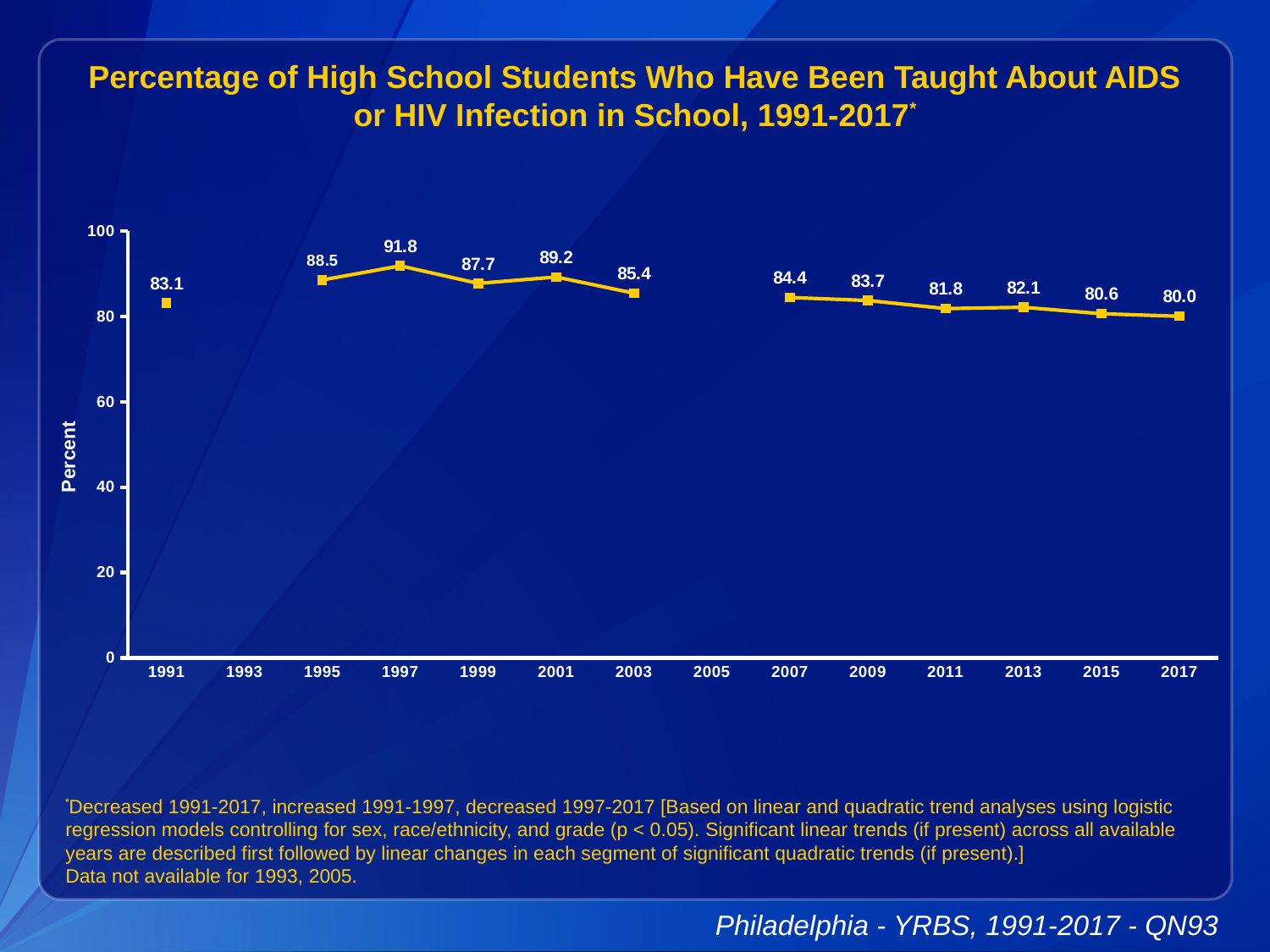
How many data points are plotted on the chart? 12 What value is shown for 2007? 84.4 What value is shown for 2017? 80.0 Is the value for 2011 greater or less than 80? greater What was the percentage of high school students taught about AIDS or HIV infection in school in 1991? 83.1 Which is larger, the value for 2001 or the value for 2003? 2001 Which year has the highest percentage? 1997 What is the label on the y axis? Percent What kind of chart is shown on the slide? line chart Which year has the lowest percentage? 2017 Do the values rise or fall from 2007 to 2017? fall What is the difference between the 1997 value and the 2017 value? 11.8